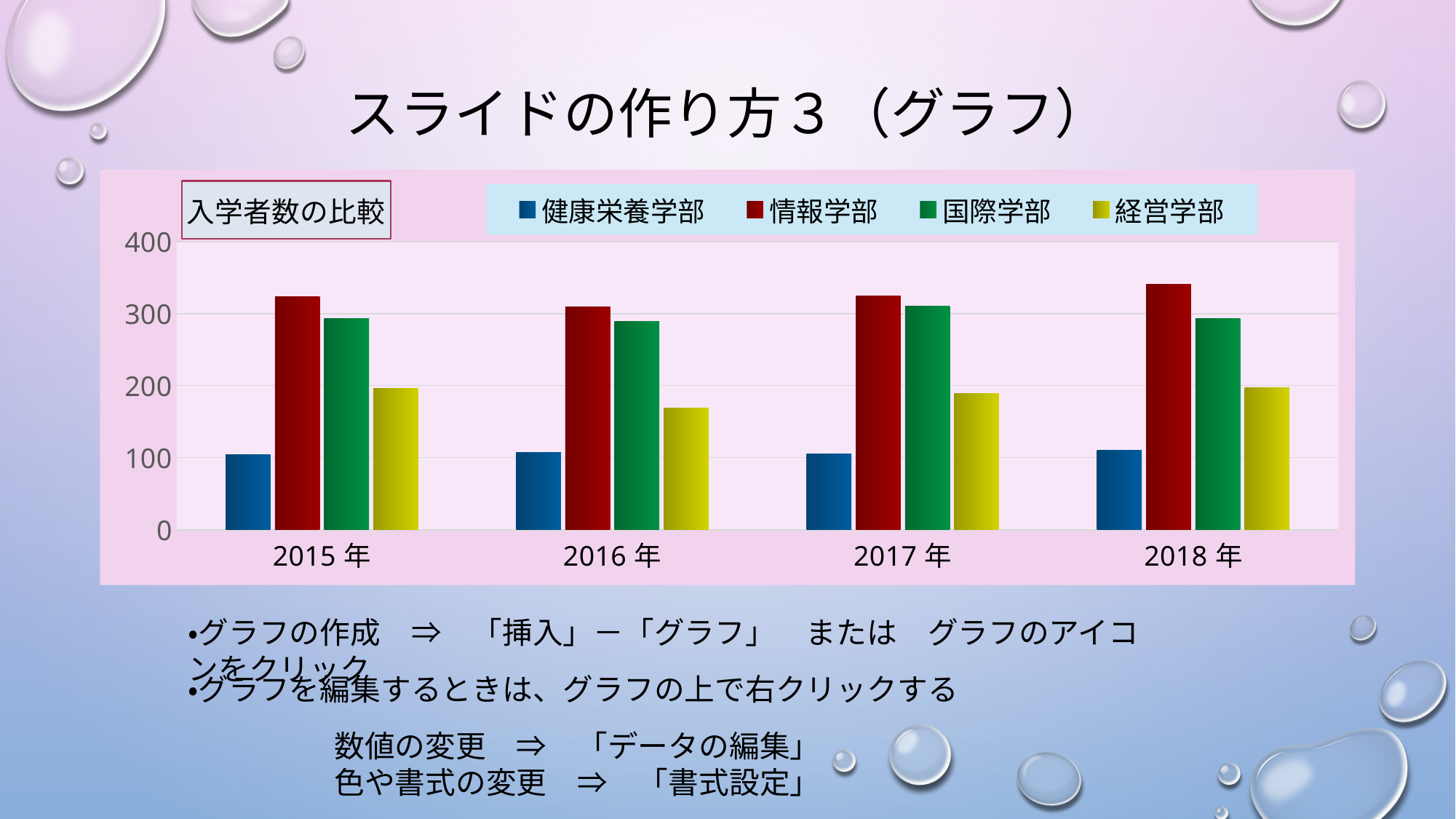
How many series does the legend list? 4 In 2016 年, which is larger: 情報学部 or 国際学部? 情報学部 Which series is shown in red in the legend? 情報学部 Which faculty has the highest value in 2015 年? 情報学部 In which year is the value for 経営学部 the lowest? 2016 年 Is the value for 経営学部 in 2016 年 greater or less than 200? less Which faculty has the lowest value in 2017 年? 健康栄養学部 What is the title of the chart? 入学者数の比較 Is the value for 情報学部 in 2018 年 greater or less than 300? greater How many year categories are shown on the x axis? 4 What kind of chart is shown on the slide? bar chart Is the value for 国際学部 in 2016 年 greater or less than 300? less